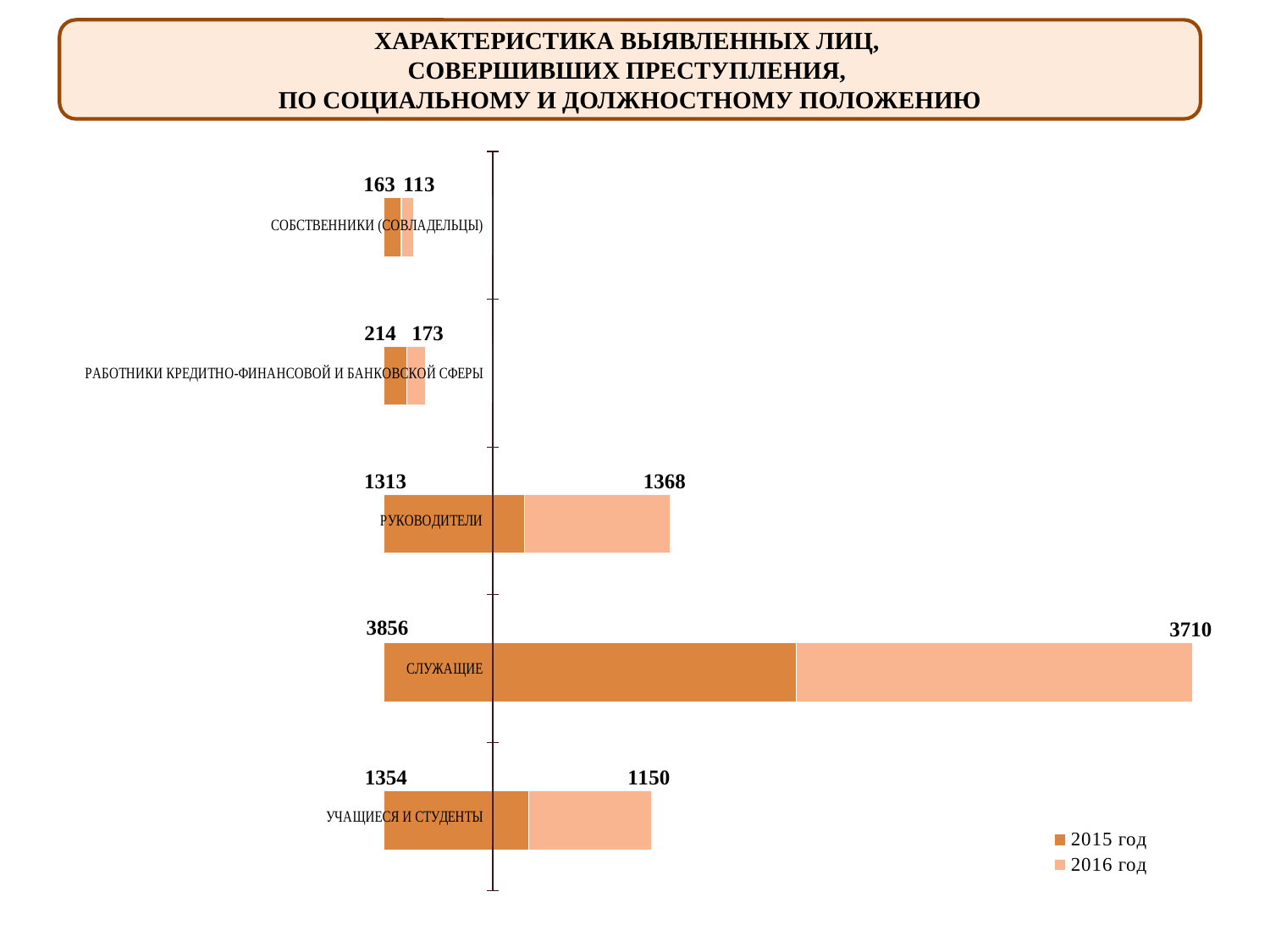
What is the value for УЧАЩИЕСЯ И СТУДЕНТЫ in 2015 год? 1354 What is the difference between the 2015 год and 2016 год values for СЛУЖАЩИЕ? 146 What kind of chart is shown on the slide? Stacked bar chart Which category has the lowest value in 2016 год? СОБСТВЕННИКИ (СОВЛАДЕЛЬЦЫ) What is the value for СОБСТВЕННИКИ (СОВЛАДЕЛЬЦЫ) in 2016 год? 113 What is the total of the stacked bar for РАБОТНИКИ КРЕДИТНО-ФИНАНСОВОЙ И БАНКОВСКОЙ СФЕРЫ? 387 How many categories are shown in the chart? 5 Which category has the highest value in 2015 год? СЛУЖАЩИЕ What is the value for РУКОВОДИТЕЛИ in 2016 год? 1368 Which is larger for РУКОВОДИТЕЛИ: the 2015 год value or the 2016 год value? 2016 год How many series does the legend list? 2 What is the value for СЛУЖАЩИЕ in 2015 год? 3856